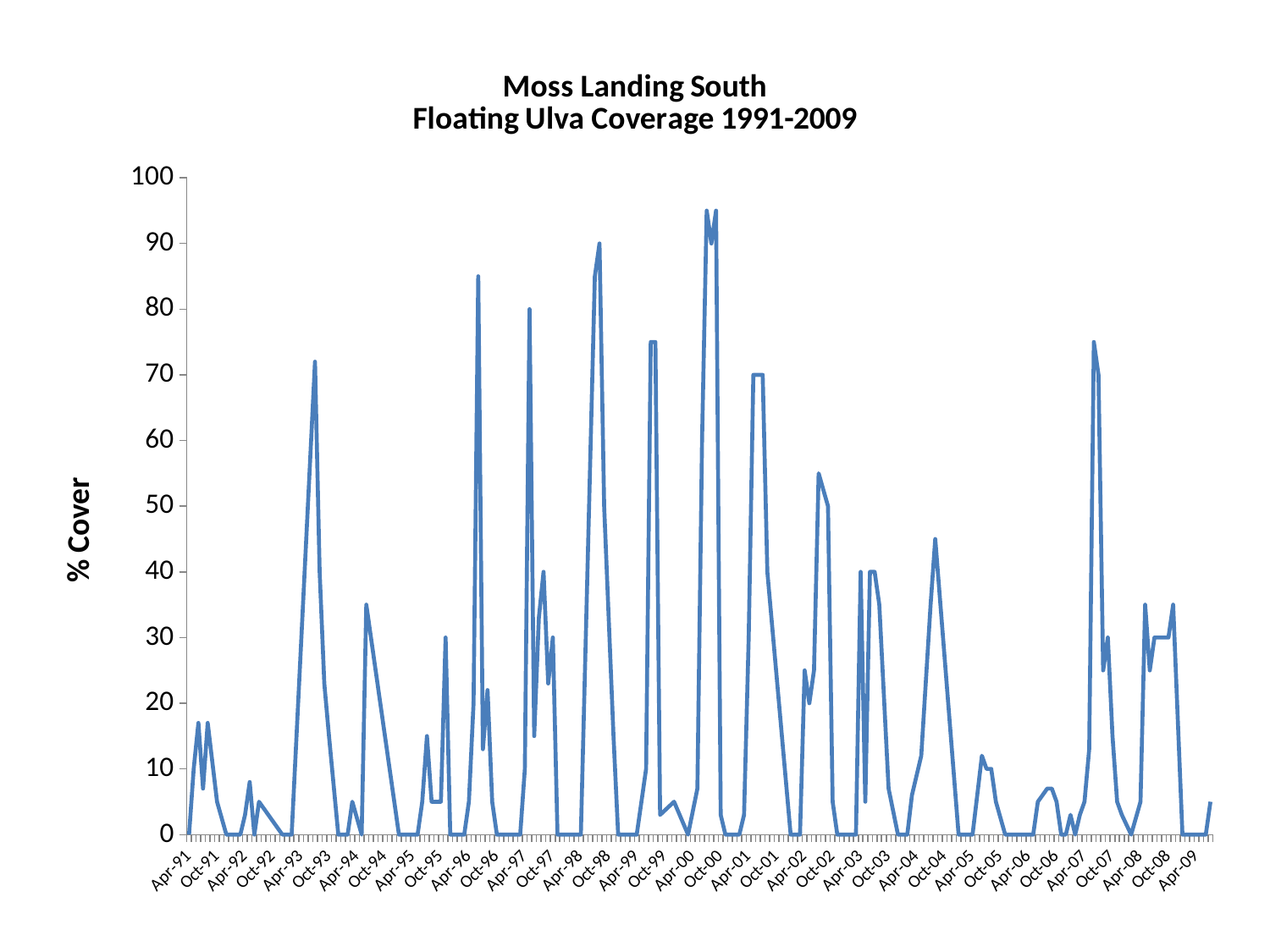
Which peak is higher: the one around Oct-93 or the one around Oct-95? Oct-93 Is the peak value around Oct-02 greater or less than 50? greater Around which x-axis label does the line reach its highest value? Oct-00 What is the title of the chart? Moss Landing South Floating Ulva Coverage 1991-2009 Is the peak value around Oct-98 greater or less than 80? greater Is the peak value around Oct-04 greater or less than 50? less How many labels are shown on the x axis? 37 What is the label on the vertical axis? % Cover What kind of chart is shown on the slide? line chart